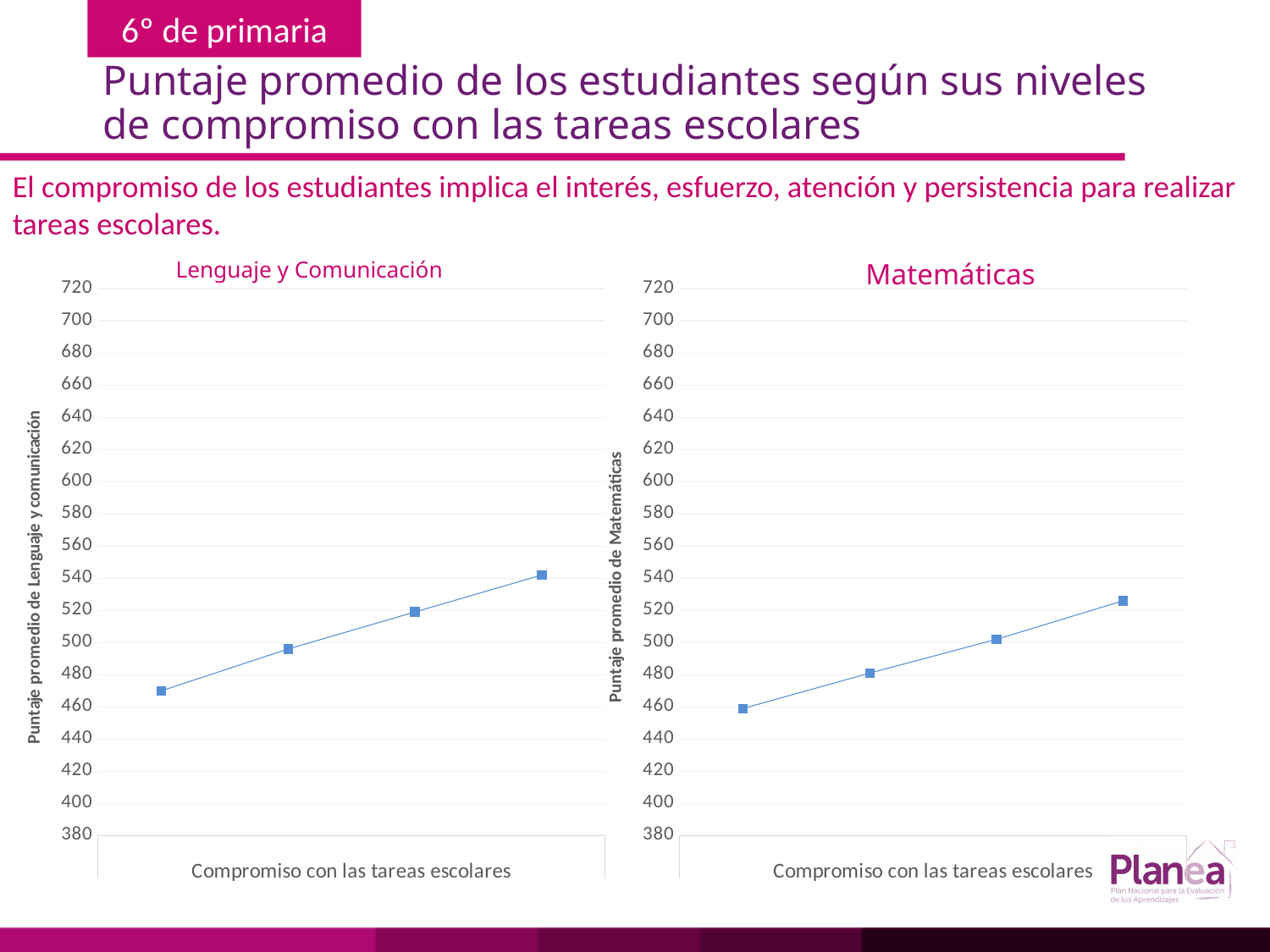
In the Matemáticas chart, do the values rise or fall from left to right? rise In the Lenguaje y Comunicación chart, is the value of the first (leftmost) point greater or less than 500? less In the Lenguaje y Comunicación chart, do the values rise or fall from left to right? rise In the Lenguaje y Comunicación chart, is the value of the last (rightmost) point greater or less than 520? greater In the Matemáticas chart, is the value of the first (leftmost) point greater or less than 480? less What is the x-axis label of the Lenguaje y Comunicación chart? Compromiso con las tareas escolares How many data points are plotted in the Matemáticas chart? 4 What kind of chart is the Matemáticas chart? line chart What kind of chart is the Lenguaje y Comunicación chart? line chart In the Matemáticas chart, which is larger, the first point or the last point? the last point How many data points are plotted in the Lenguaje y Comunicación chart? 4